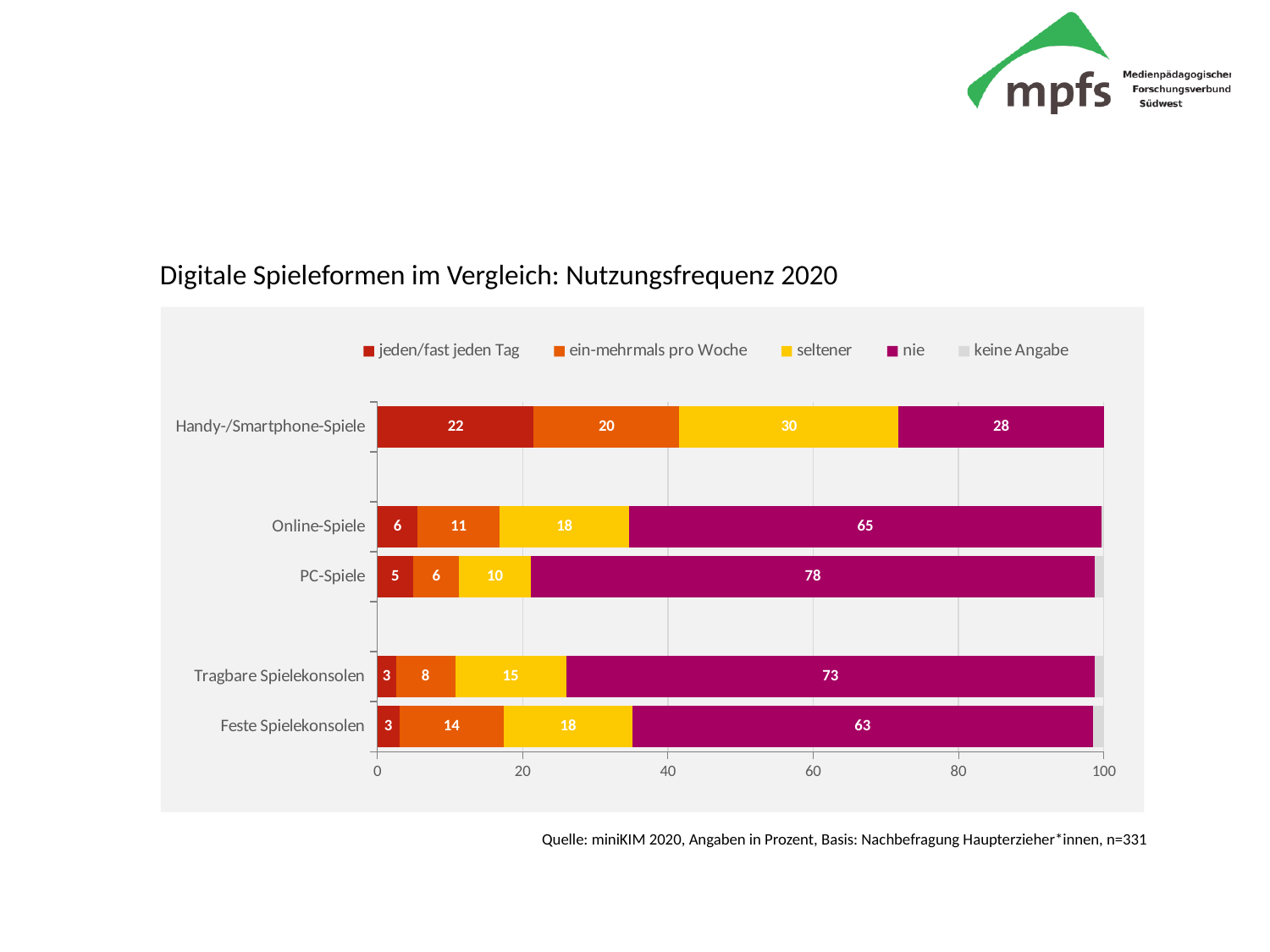
Which category has the lowest value for "nie"? Handy-/Smartphone-Spiele What is the difference between the "nie" values for PC-Spiele and Online-Spiele? 13 What kind of chart is shown on the slide? Stacked bar chart What is the title of the chart? Digitale Spieleformen im Vergleich: Nutzungsfrequenz 2020 What is the value for "seltener" for Tragbare Spielekonsolen? 15 Which is larger: the "seltener" value for Handy-/Smartphone-Spiele or for Online-Spiele? Handy-/Smartphone-Spiele What is the value for "nie" for PC-Spiele? 78 What is the value for "jeden/fast jeden Tag" for Handy-/Smartphone-Spiele? 22 Which category has the highest value for "nie"? PC-Spiele How many series does the legend list? 5 What is the value for "ein-mehrmals pro Woche" for Feste Spielekonsolen? 14 How many categories are shown on the y axis? 5